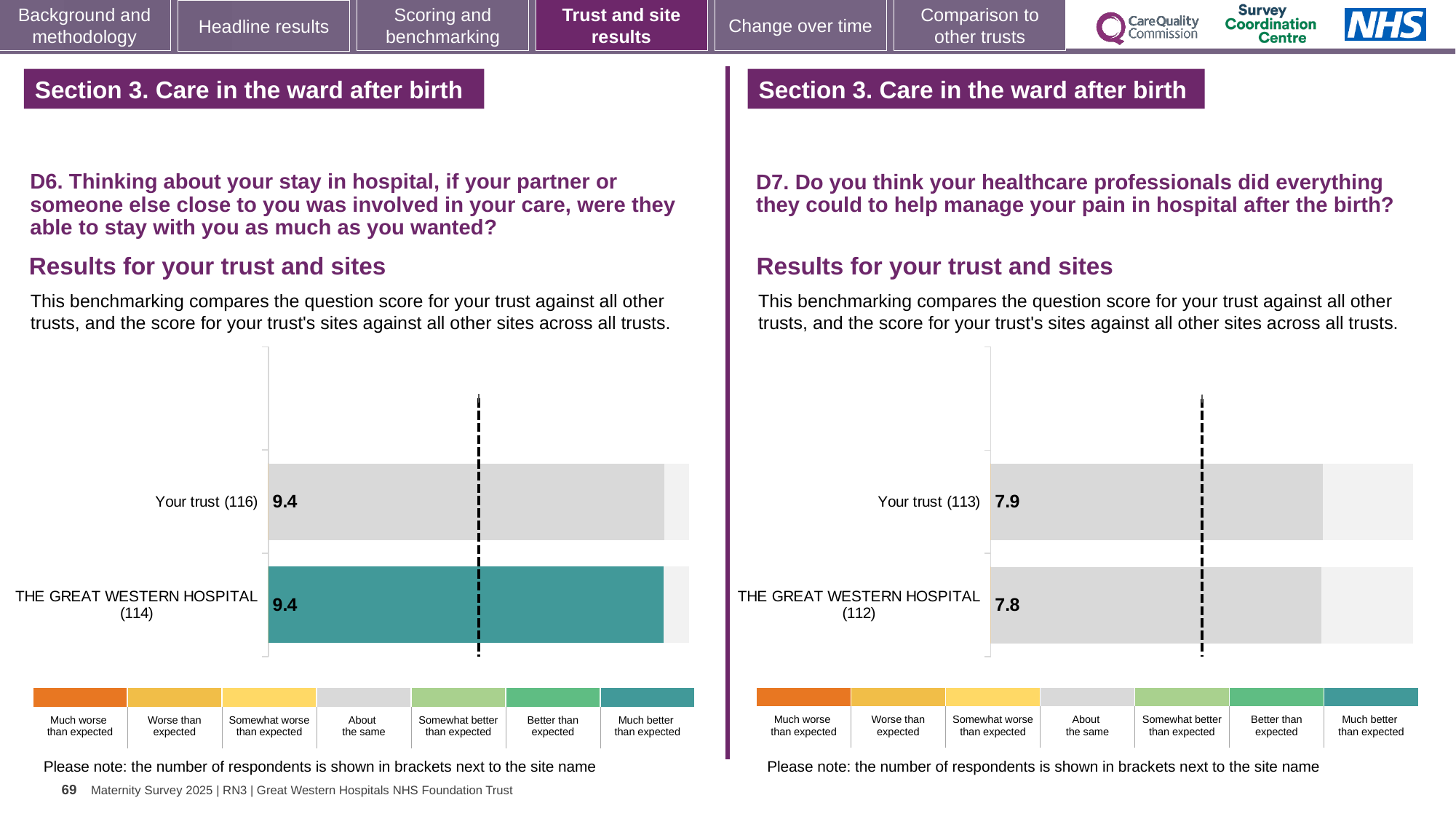
In the D6 chart on the left, which benchmark category does the colour of the THE GREAT WESTERN HOSPITAL bar correspond to in the key? Much better than expected What type of chart is used for the D7 results on the right? Bar chart In the D7 chart on the right, what is the score for Your trust? 7.9 In the D7 chart on the right, what is the score for THE GREAT WESTERN HOSPITAL? 7.8 In the D7 chart on the right, what is the difference between the score for Your trust and the score for THE GREAT WESTERN HOSPITAL? 0.1 In the D6 chart on the left, is the score for Your trust the same as the score for THE GREAT WESTERN HOSPITAL? Yes In the D6 chart on the left, what is the score for THE GREAT WESTERN HOSPITAL? 9.4 In the D6 chart on the left, what is the score for Your trust? 9.4 In the D6 chart on the left, how many respondents are shown in brackets for THE GREAT WESTERN HOSPITAL? 114 In the D7 chart on the right, how many respondents are shown in brackets for Your trust? 113 In the D7 chart on the right, which has the higher score, Your trust or THE GREAT WESTERN HOSPITAL? Your trust How many bars are plotted in the D6 chart on the left? 2